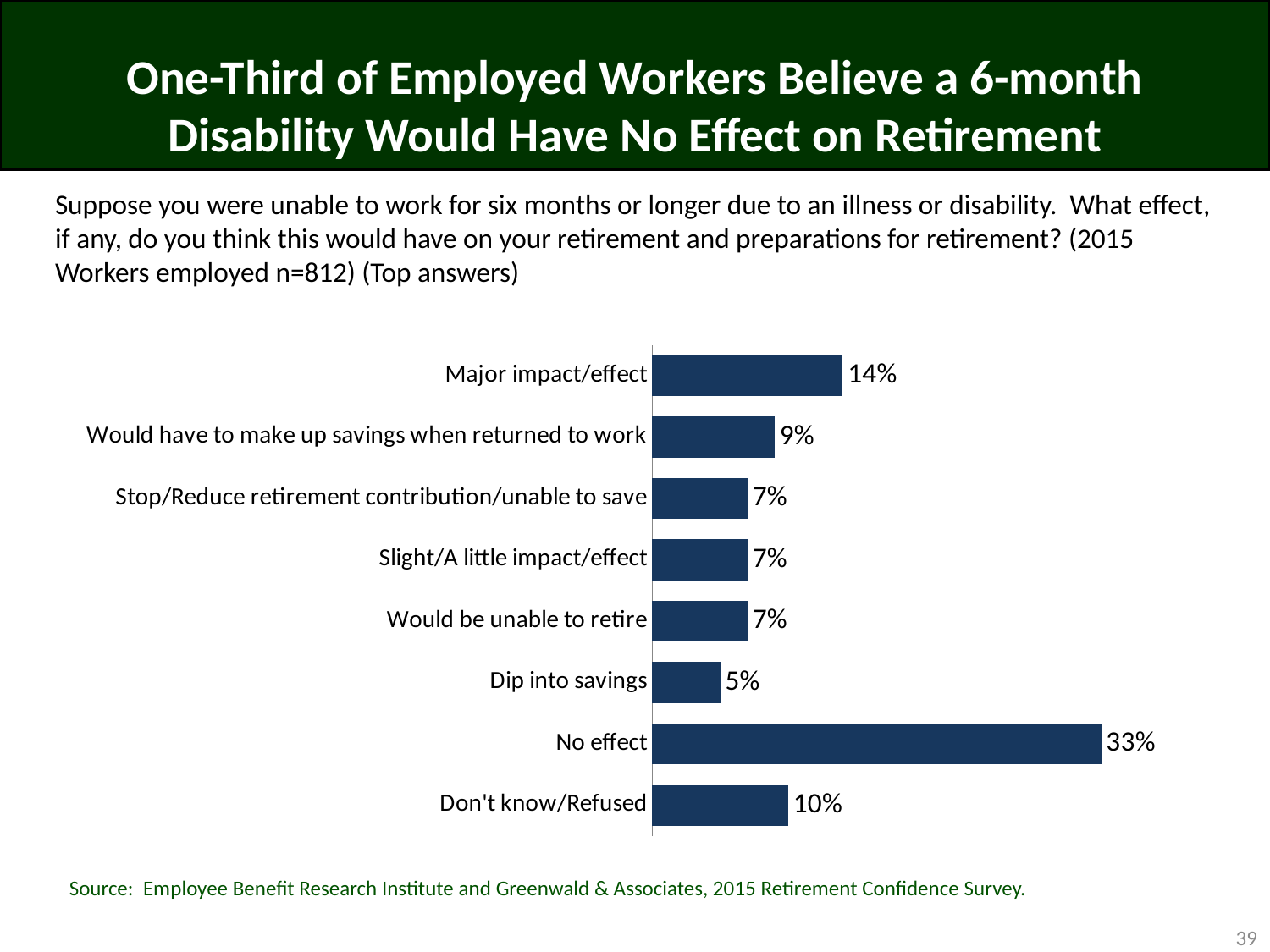
How many response categories are shown in the chart? 8 What is the value for "Major impact/effect"? 14% Which response category has the lowest value? Dip into savings Which is larger, the value for "Major impact/effect" or the value for "Would have to make up savings when returned to work"? Major impact/effect What percentage of employed workers said a 6-month disability would have no effect on their retirement? 33% Which response category has the highest value? No effect What is the difference between "Don't know/Refused" and "Dip into savings"? 5% How many categories share the value 7%? 3 What is the difference between the values for "No effect" and "Major impact/effect"? 19% What kind of chart is shown on the slide? Bar chart What is the value for "Don't know/Refused"? 10% What percentage answered "Would have to make up savings when returned to work"? 9%